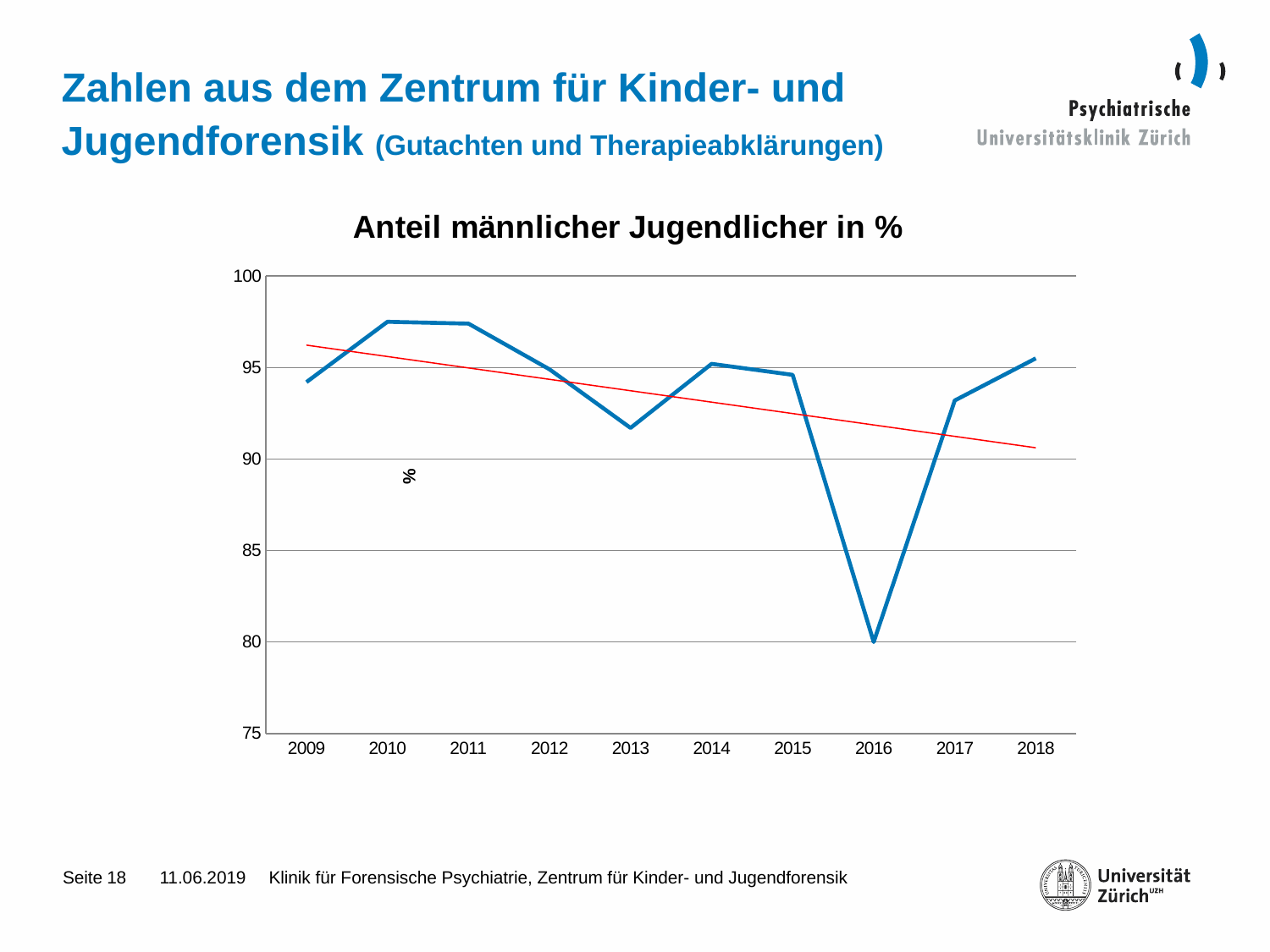
Does the red trend line rise or fall from 2009 to 2018? fall What is the title of the chart? Anteil männlicher Jugendlicher in % What kind of chart is shown on the slide? line chart Is the value for 2013 greater or less than 95? less How many years are plotted along the x axis? 10 Is the value for 2010 greater or less than 95? greater Which year has the larger value, 2013 or 2016? 2013 Which year has the larger value, 2009 or 2010? 2010 What is the value for 2016? 80 Is the value for 2017 greater or less than 95? less Which year has the lowest share of male adolescents? 2016